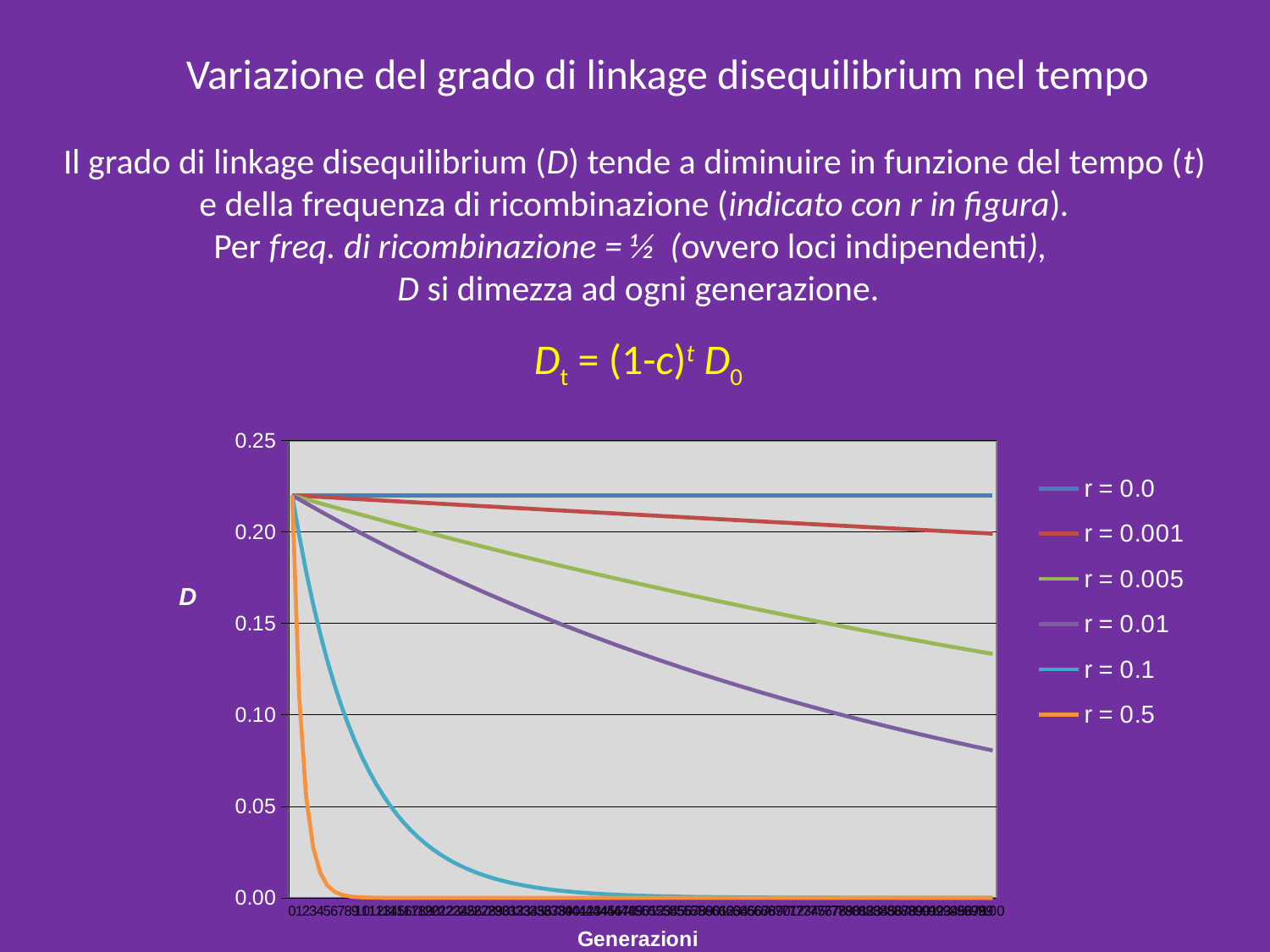
At the last generation shown, which series has the higher value of D: r = 0.01 or r = 0.005? r = 0.005 At the last generation shown, is the value of D for r = 0.01 greater or less than 0.10? less At the last generation shown, is the value of D for r = 0.005 greater or less than 0.15? less What is the title of the x axis of the chart? Generazioni How many series does the chart legend list? 6 Which series in the chart decreases fastest over the generations? r = 0.5 What is the highest value shown on the y axis of the chart? 0.25 What kind of chart is shown on the slide? line chart What is the label on the y axis of the chart? D At the last generation shown, is the value of D for r = 0.0 greater or less than 0.20? greater Which series in the chart stays flat across all generations? r = 0.0 Does the value of D for the series r = 0.1 rise or fall as the generations increase? fall